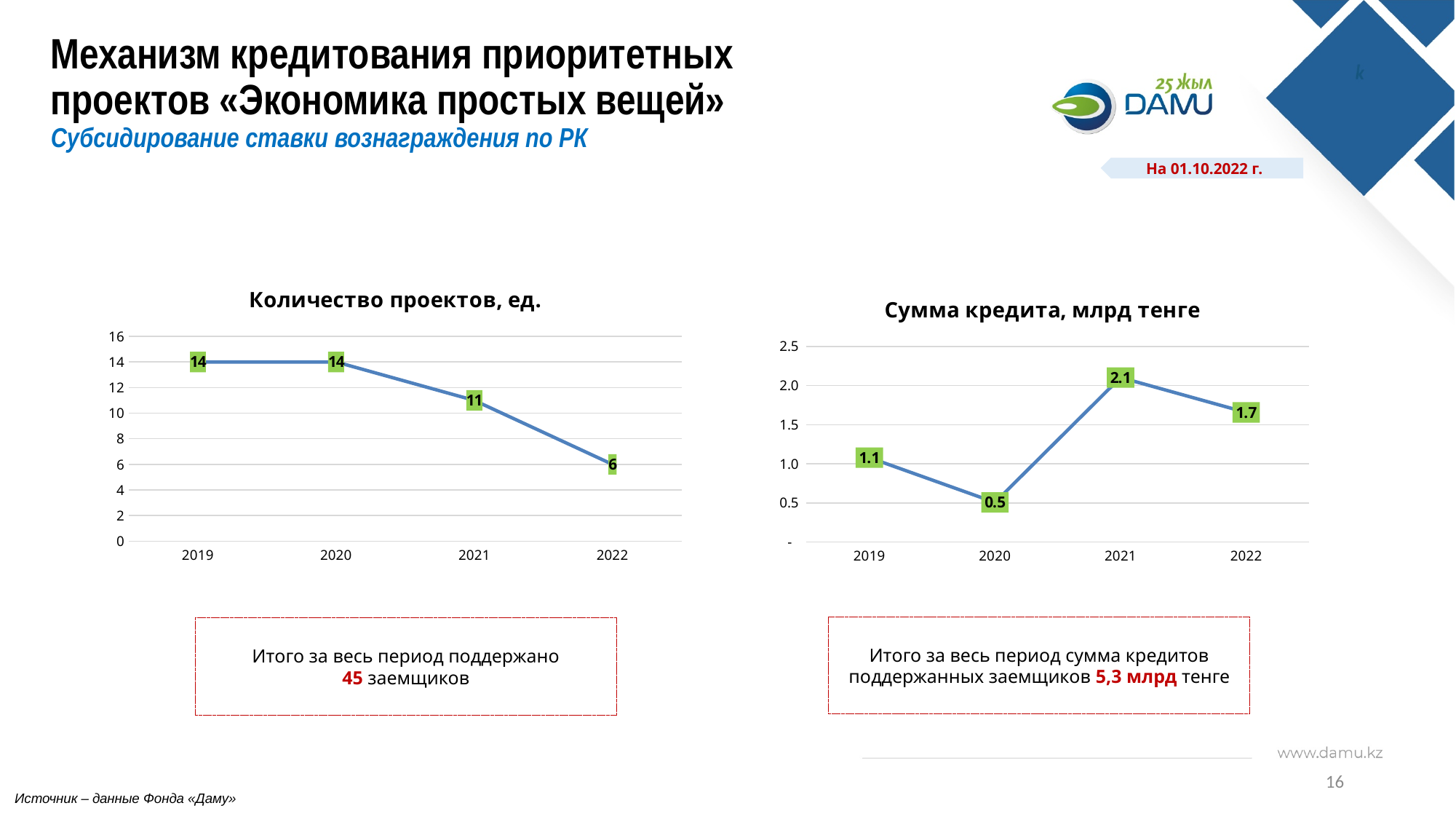
How many data points are plotted in the chart 'Количество проектов, ед.'? 4 In the chart 'Количество проектов, ед.', do the values rise or fall from 2020 to 2022? Fall In the chart 'Сумма кредита, млрд тенге', what is the value for 2022? 1.7 In the chart 'Сумма кредита, млрд тенге', which is larger, the value for 2019 or the value for 2022? 2022 What type of chart is 'Сумма кредита, млрд тенге'? Line chart In the chart 'Количество проектов, ед.', what is the difference between the values for 2020 and 2022? 8 In the chart 'Количество проектов, ед.', which year has the lowest value? 2022 In the chart 'Сумма кредита, млрд тенге', what is the value for 2020? 0.5 In the chart 'Количество проектов, ед.', what is the value for 2021? 11 In the chart 'Сумма кредита, млрд тенге', which year has the highest value? 2021 In the chart 'Количество проектов, ед.', what is the value for 2022? 6 In the chart 'Сумма кредита, млрд тенге', what is the difference between the values for 2021 and 2020? 1.6